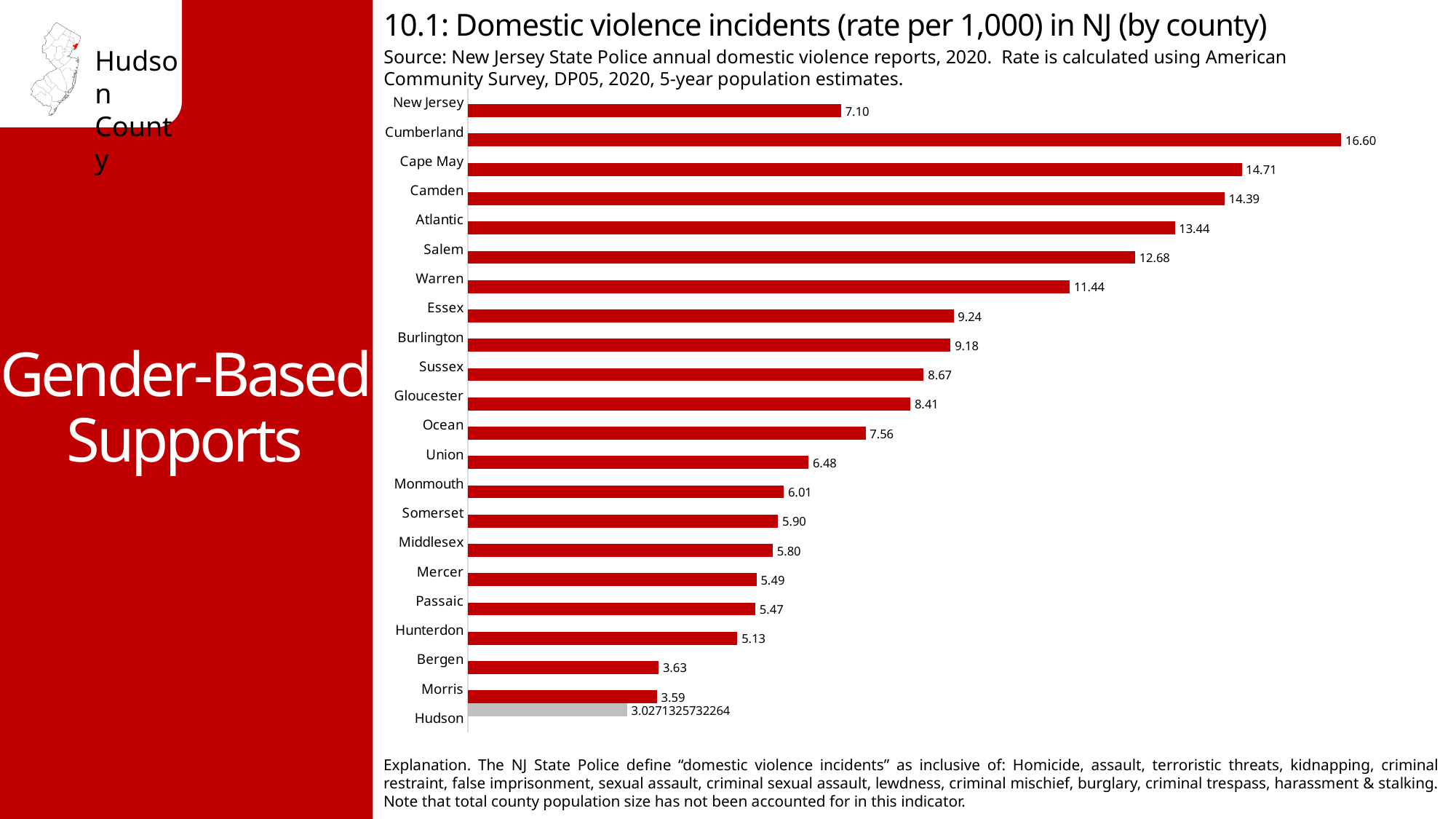
What value is printed on the bar for Hudson county? 3.0271325732264 Which county has the highest domestic violence incident rate on the chart? Cumberland Which has a higher rate, Union or Monmouth? Union What type of chart is used to show the domestic violence incident rates? Bar chart Which has a higher rate, Camden or Atlantic? Camden How many bars (categories) are plotted on the chart? 22 Which county has the lowest domestic violence incident rate on the chart? Hudson Which bar is shown in a different colour (grey) from the others? Hudson How much higher is Ocean county's rate than the New Jersey statewide rate? 0.46 What is the rate per 1,000 shown for New Jersey as a whole? 7.10 What is the domestic violence incident rate per 1,000 for Cumberland county? 16.60 What is the difference between the rates for Cumberland and Cape May? 1.89